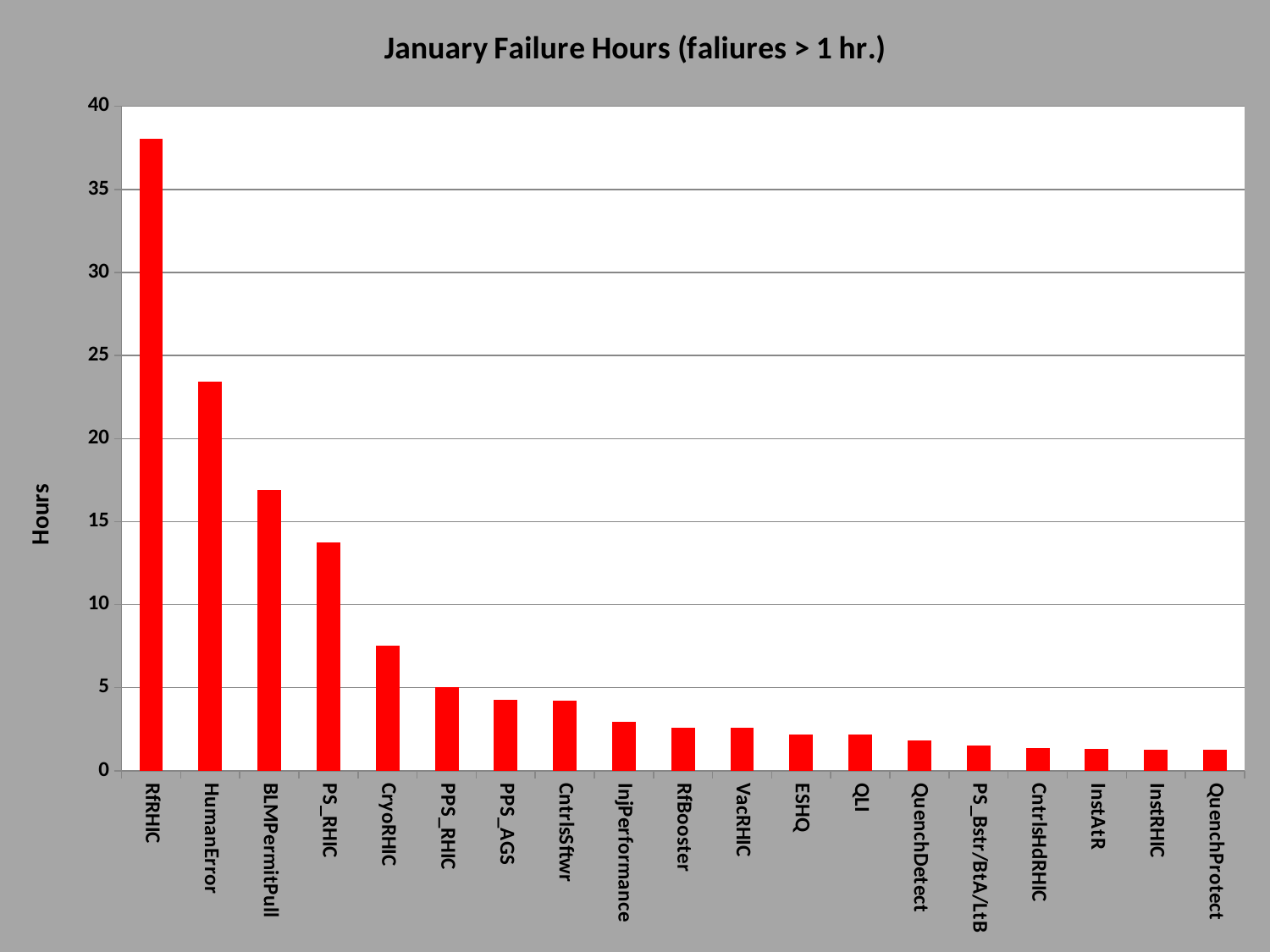
What is the title of the chart? January Failure Hours (faliures > 1 hr.) Is the value for RfRHIC greater or less than 35? greater Which category has the highest failure hours? RfRHIC Which is larger, the value for HumanError or the value for BLMPermitPull? HumanError Which is larger, the value for PS_RHIC or the value for CryoRHIC? PS_RHIC What kind of chart is shown on the slide? bar chart Is the value for CryoRHIC greater or less than 10? less Is the value for BLMPermitPull greater or less than 15? greater How many categories are shown on the x axis? 19 Do the values generally rise or fall moving from left to right along the x axis? fall What is the label of the y axis? Hours